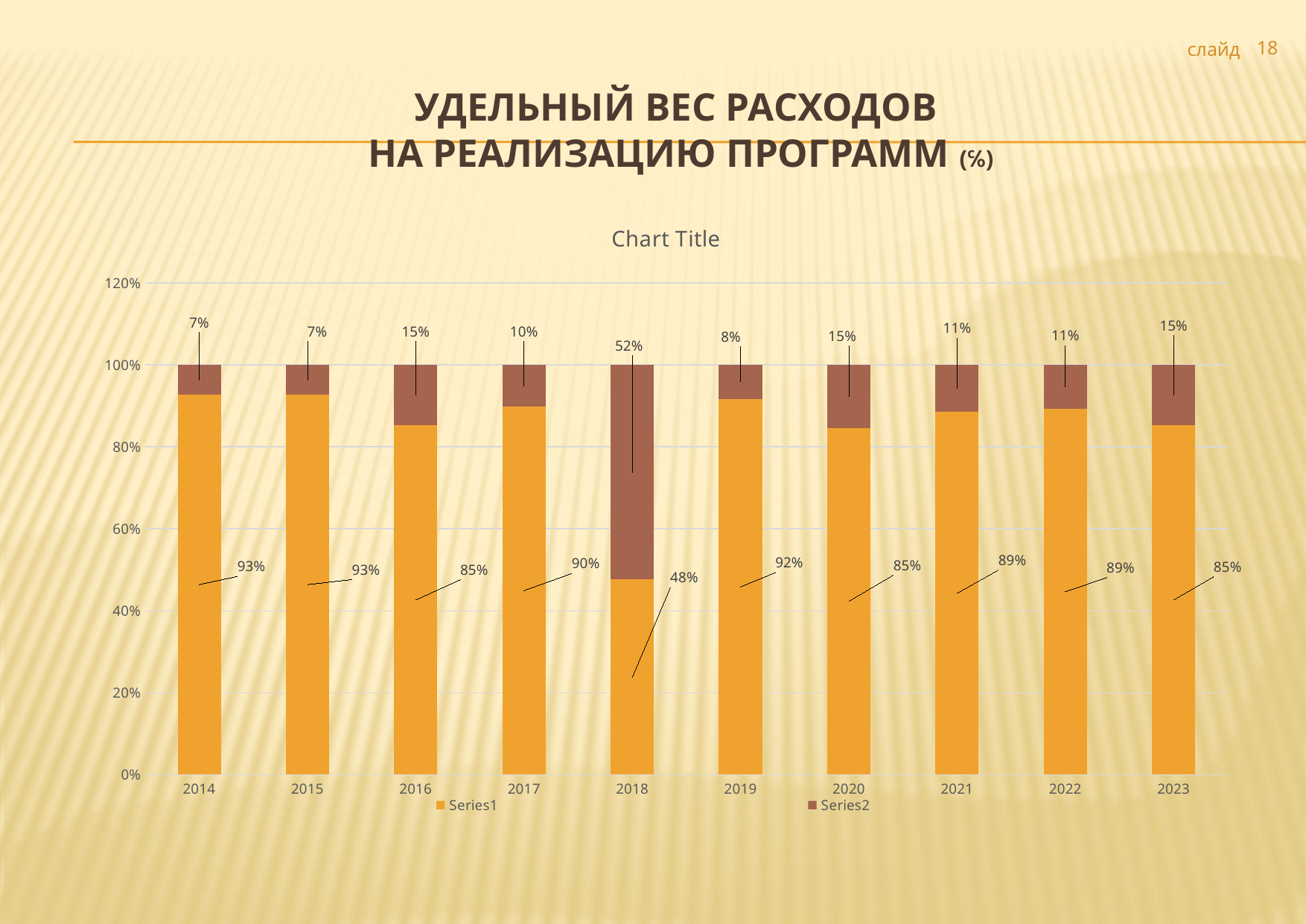
What is the value of Series1 for 2017? 90% How many series does the legend list? 2 Which is larger, the Series2 value for 2019 or for 2020? 2020 How many years are shown on the x axis? 10 What is the chart title printed above the plot area? Chart Title Which year has the lowest Series1 value? 2018 What is the value of Series2 for 2021? 11% What is the difference between the Series1 values for 2014 and 2016? 8% What is the value of Series1 for 2018? 48% What is the total of the stacked bar for 2022? 100% Which year has the highest Series2 value? 2018 What kind of chart is shown on the slide? stacked bar chart